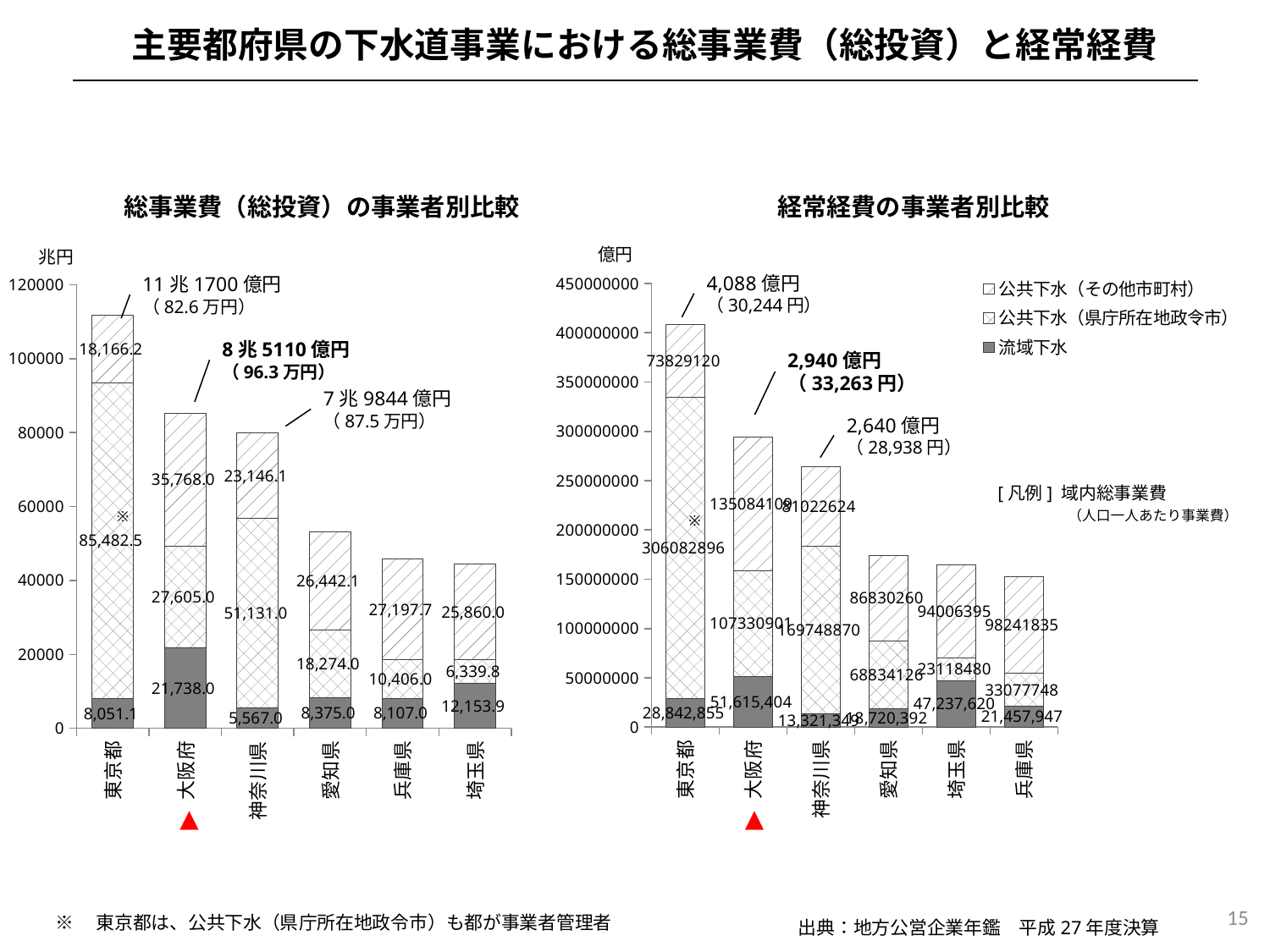
How many series does the legend on the slide list? 3 In the right chart (経常経費の事業者別比較), what is the value of 流域下水 for 埼玉県? 47,237,620 In the left chart (総事業費（総投資）の事業者別比較), what is the total of the stacked bar for 愛知県? 53,091.1 What kind of chart is the left chart (総事業費（総投資）の事業者別比較)? Stacked bar chart In the left chart (総事業費（総投資）の事業者別比較), what is the value of 流域下水 for 大阪府? 21,738.0 In the right chart (経常経費の事業者別比較), is the total for 神奈川県 greater or less than 250000000? greater In the left chart (総事業費（総投資）の事業者別比較), is the 流域下水 value larger for 大阪府 or for 神奈川県? 大阪府 In the left chart (総事業費（総投資）の事業者別比較), what is the value of 公共下水（その他市町村） for 神奈川県? 23,146.1 In the right chart (経常経費の事業者別比較), which prefecture has the shortest stacked bar? 兵庫県 In the right chart (経常経費の事業者別比較), what is the value of 公共下水（その他市町村） for 兵庫県? 98241835 In the left chart (総事業費（総投資）の事業者別比較), what is the difference between the 流域下水 values for 埼玉県 and 兵庫県? 4,046.9 In the left chart (総事業費（総投資）の事業者別比較), which prefecture has the tallest stacked bar? 東京都